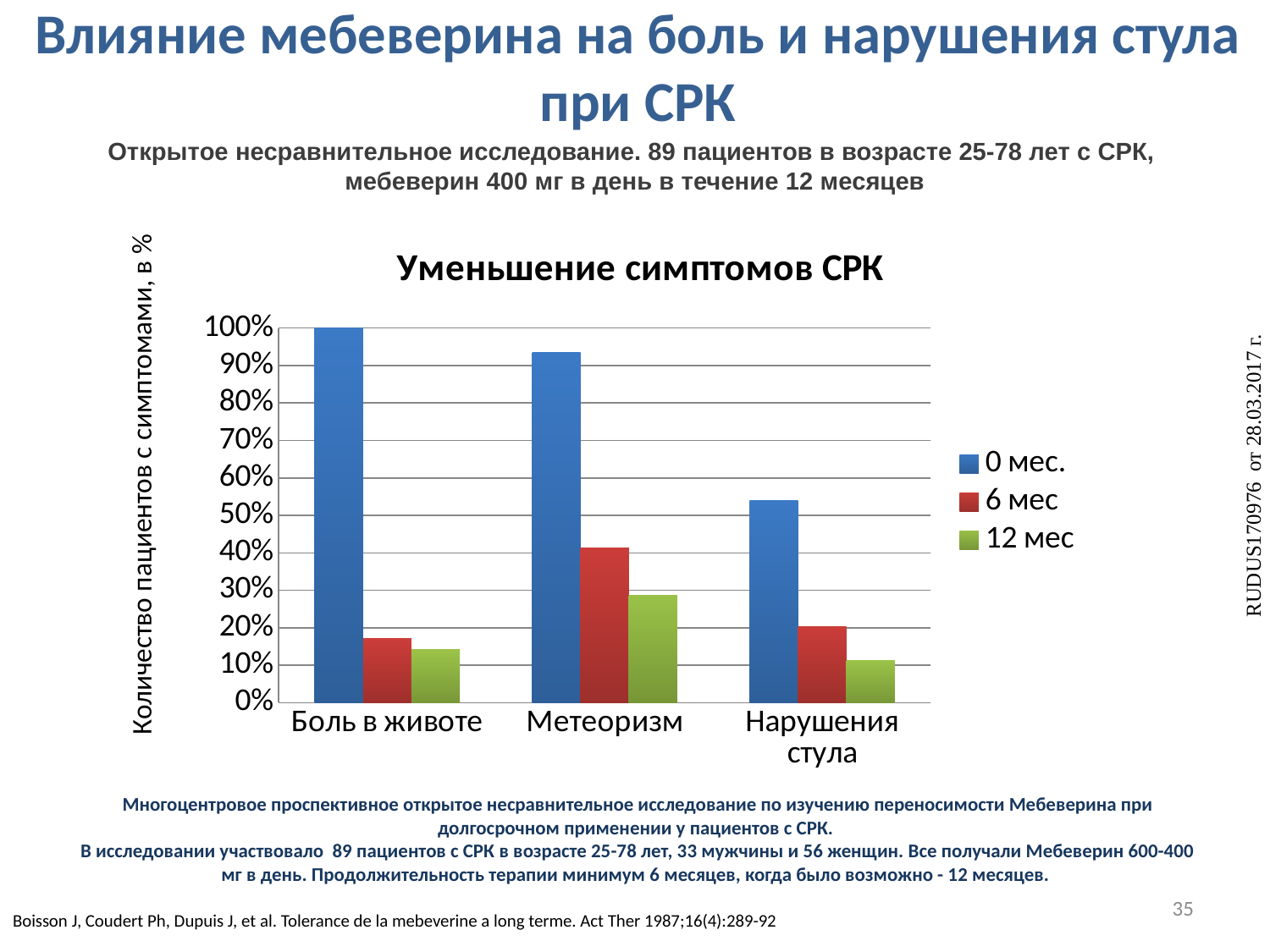
Is the value for Нарушения стула at 0 мес. greater or less than 50%? greater What is the value for Боль в животе at 0 мес.? 100% How many series does the legend list? 3 Is the value for Метеоризм at 0 мес. greater or less than 90%? greater How many symptom categories are shown on the x axis? 3 What kind of chart is shown on the slide? bar chart Which is larger at 12 мес: Метеоризм or Нарушения стула? Метеоризм Which category has the highest value for the 0 мес. series? Боль в животе Is the value for Боль в животе at 6 мес greater or less than 20%? less What is the title of the chart? Уменьшение симптомов СРК Which category has the lowest value for the 0 мес. series? Нарушения стула